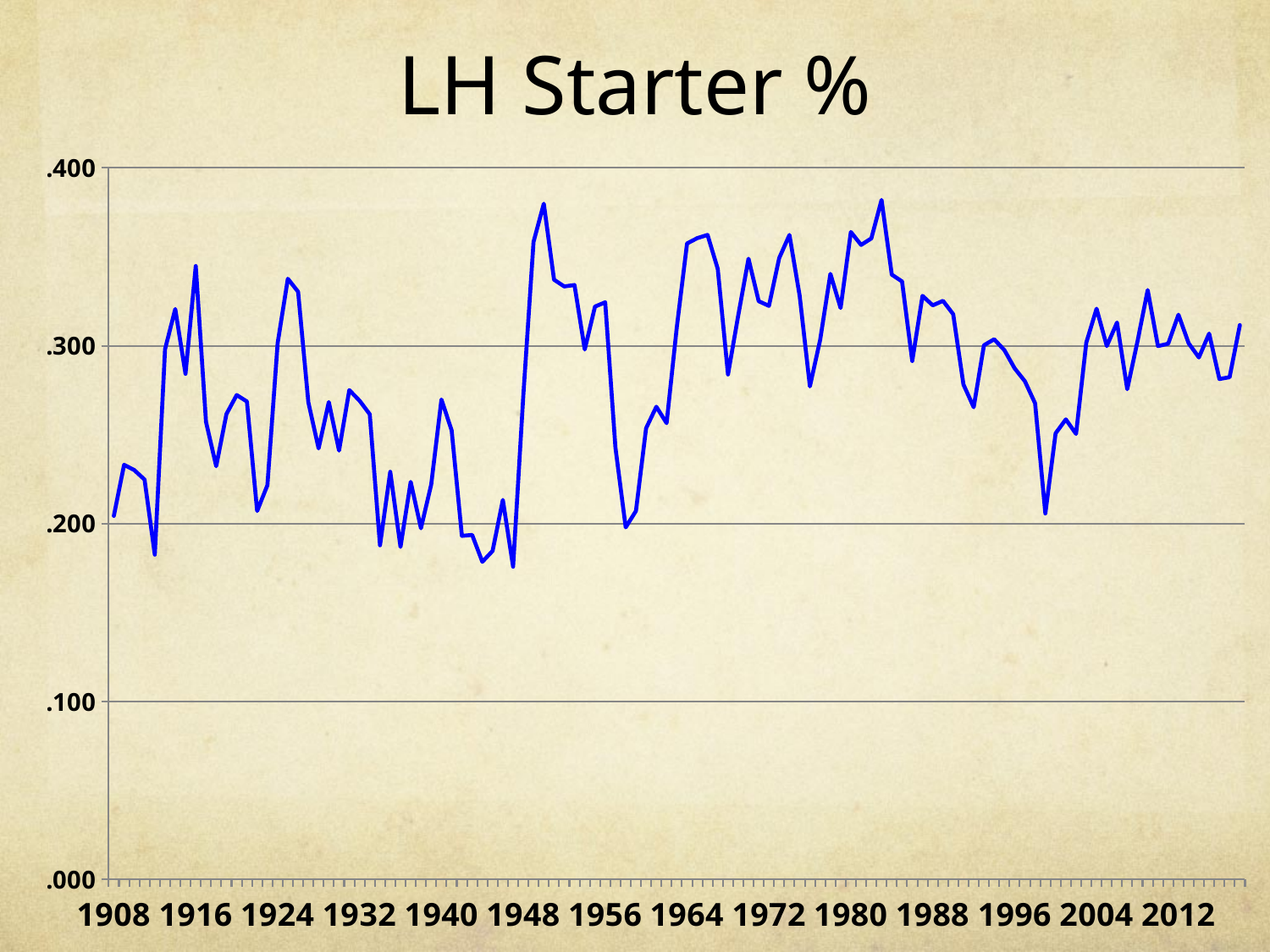
Is the value for 1980 greater or less than .300? greater What kind of chart is shown on the slide? line chart What is the first year labelled on the x axis? 1908 Is the value for 1940 greater or less than .300? less Is the value for 1916 greater or less than .300? greater What is the title of the chart? LH Starter % Which year has the larger value, 1916 or 1932? 1916